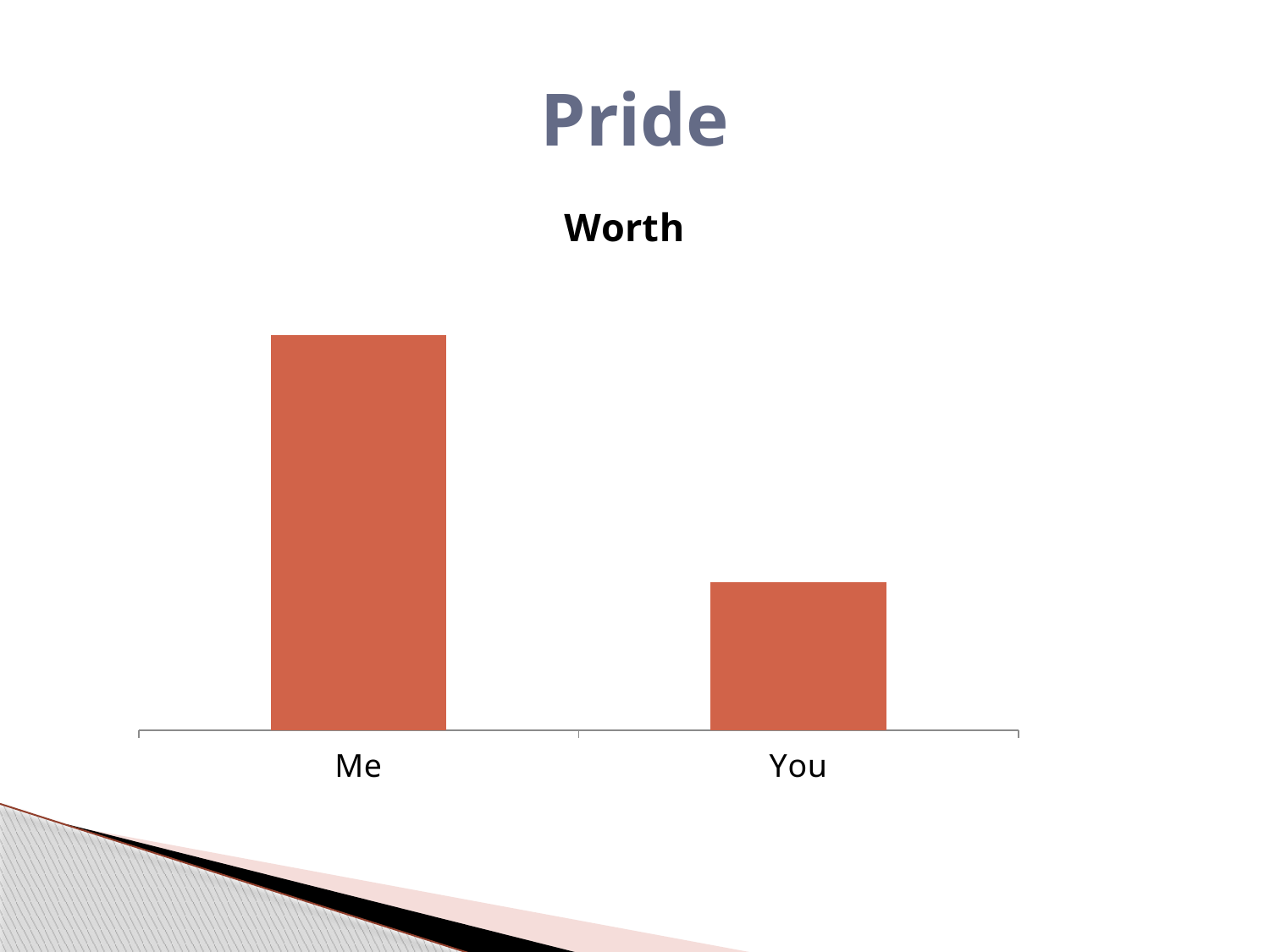
Which category has the highest bar in the chart? Me Is the bar for Me taller or shorter than the bar for You? taller What kind of chart is shown on the slide? bar chart What is the title of the chart? Worth Which category has the lowest bar in the chart? You What are the category labels on the x axis of the chart? Me, You How many categories are shown on the x axis of the chart? 2 Do the bar values rise or fall from Me to You along the x axis? fall